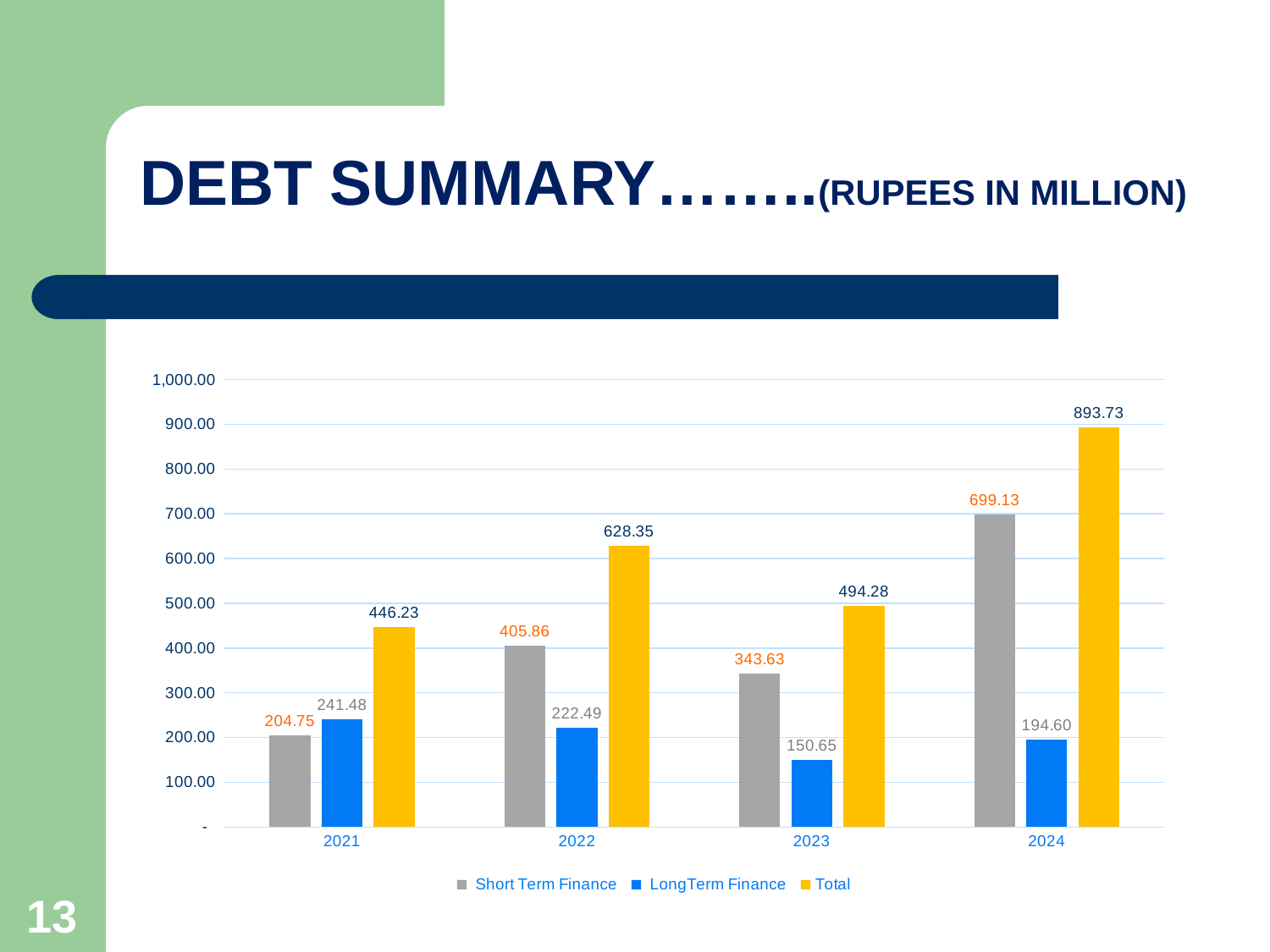
Which year has the highest Total? 2024 What is the Total value for 2024? 893.73 What is the LongTerm Finance value for 2023? 150.65 What is the difference between the Total for 2022 and the Total for 2021? 182.12 Which is larger in 2021, Short Term Finance or LongTerm Finance? LongTerm Finance Which year has the lowest LongTerm Finance value? 2023 How many years are shown on the x axis? 4 What is the Short Term Finance value for 2021? 204.75 What kind of chart is shown on the slide? Bar chart Is the Short Term Finance value for 2024 greater or less than 600.00? greater Does the Short Term Finance value rise or fall from 2023 to 2024? Rise How many series does the legend list? 3